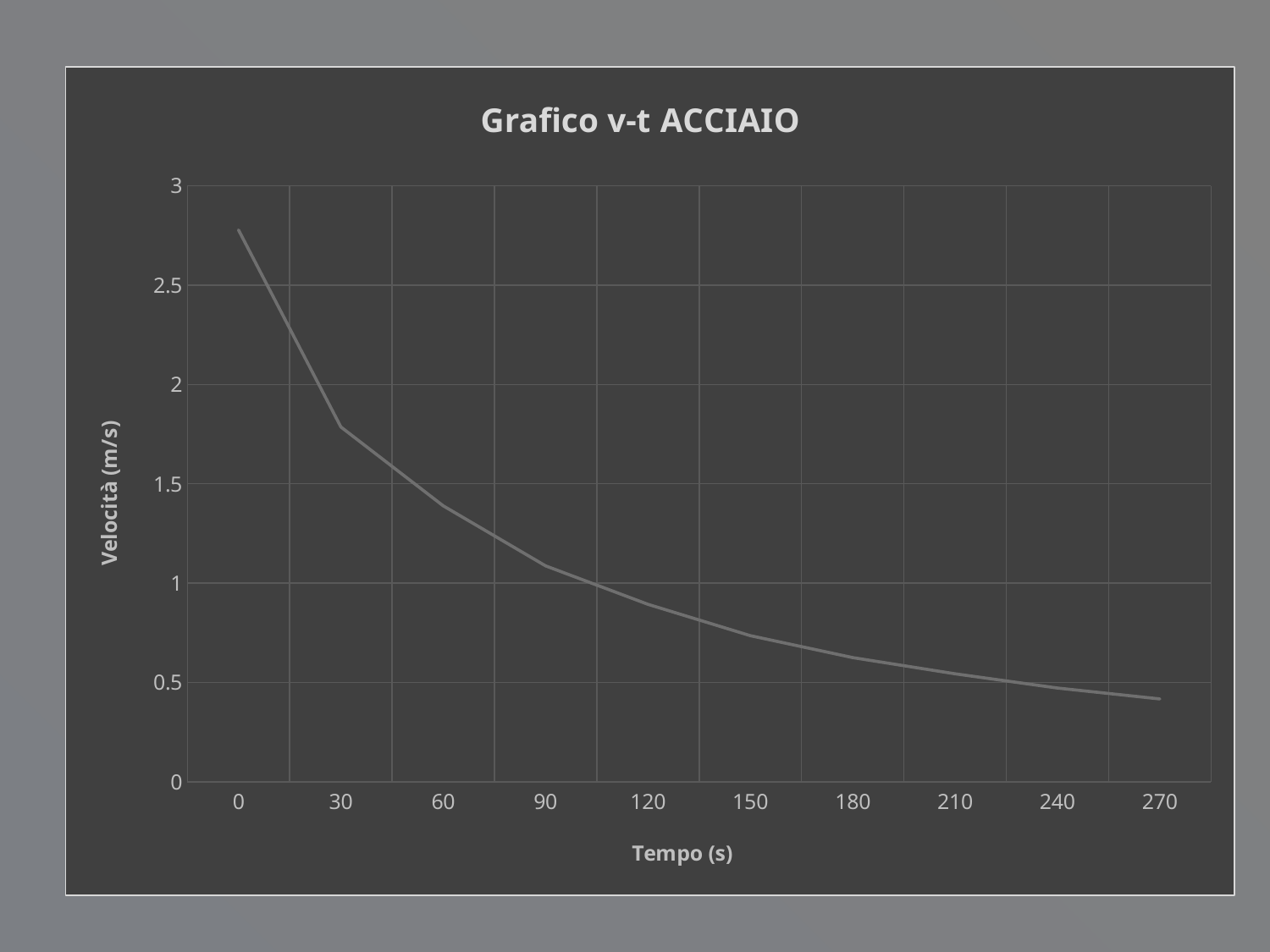
At which time is the velocity highest? 0 Is the value at time 270 greater or less than 0.5? less Is the value at time 120 greater or less than 1? less Is the value at time 0 greater or less than 2.5? greater What is the title of the chart? Grafico v-t ACCIAIO What kind of chart is shown on the slide? line chart What is the label of the vertical axis? Velocità (m/s) Which is larger, the value at time 90 or the value at time 180? 90 At which time is the velocity lowest? 270 Do the values rise or fall as time increases along the x axis? fall